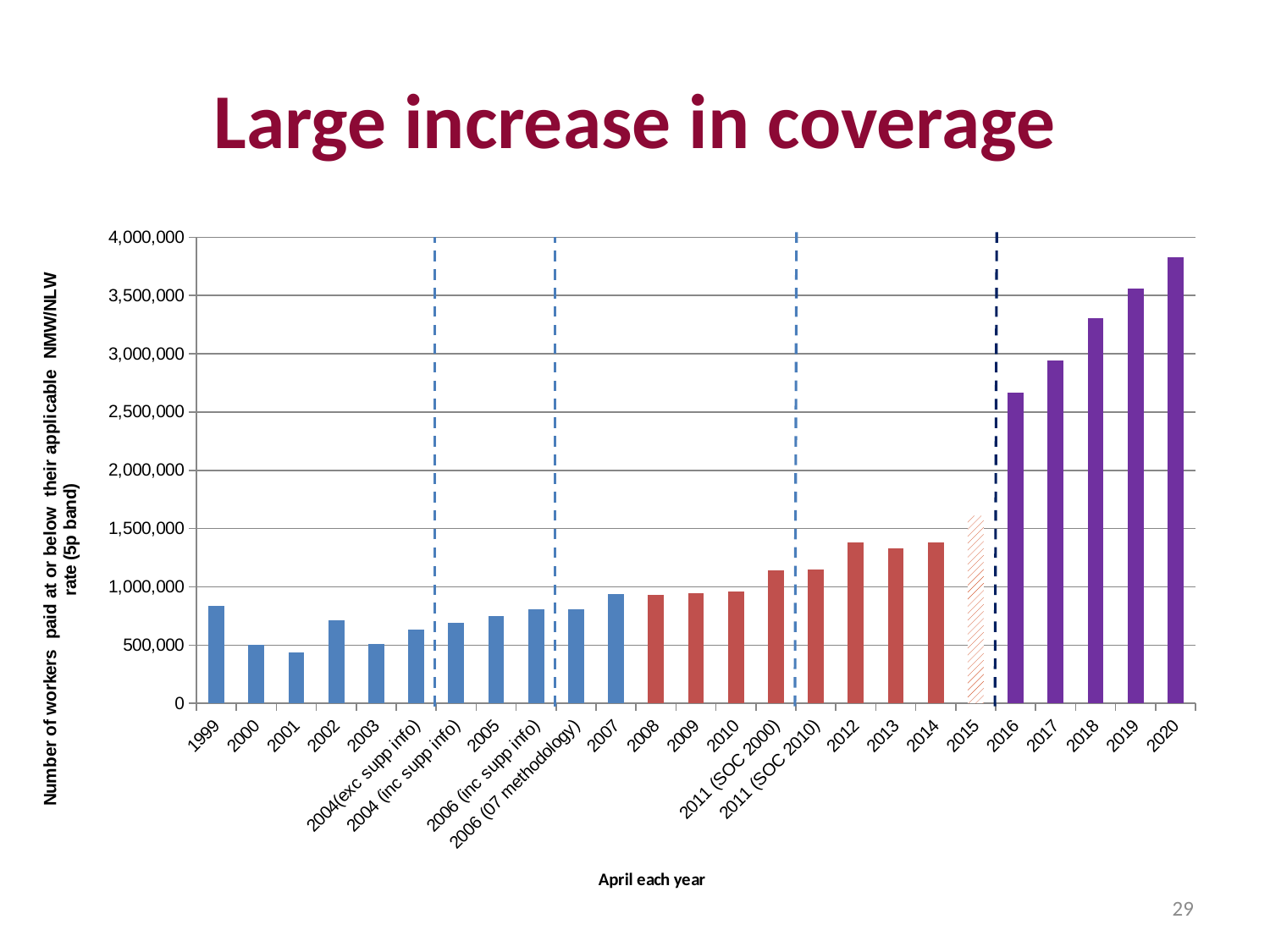
Is the value for 2007 greater or less than 1,000,000? less Is the value for 2001 greater or less than 500,000? less Is the value for 2020 greater or less than 3,500,000? greater Do the values rise or fall from 2016 to 2020? rise What kind of chart is shown on the slide? bar chart Which is larger, the value for 2019 or the value for 2018? 2019 Which year has the highest number of workers paid at or below their applicable NMW/NLW rate? 2020 Which is larger, the value for 1999 or the value for 2000? 1999 Which year has the lowest number of workers paid at or below their applicable NMW/NLW rate? 2001 What is the title of the x axis? April each year